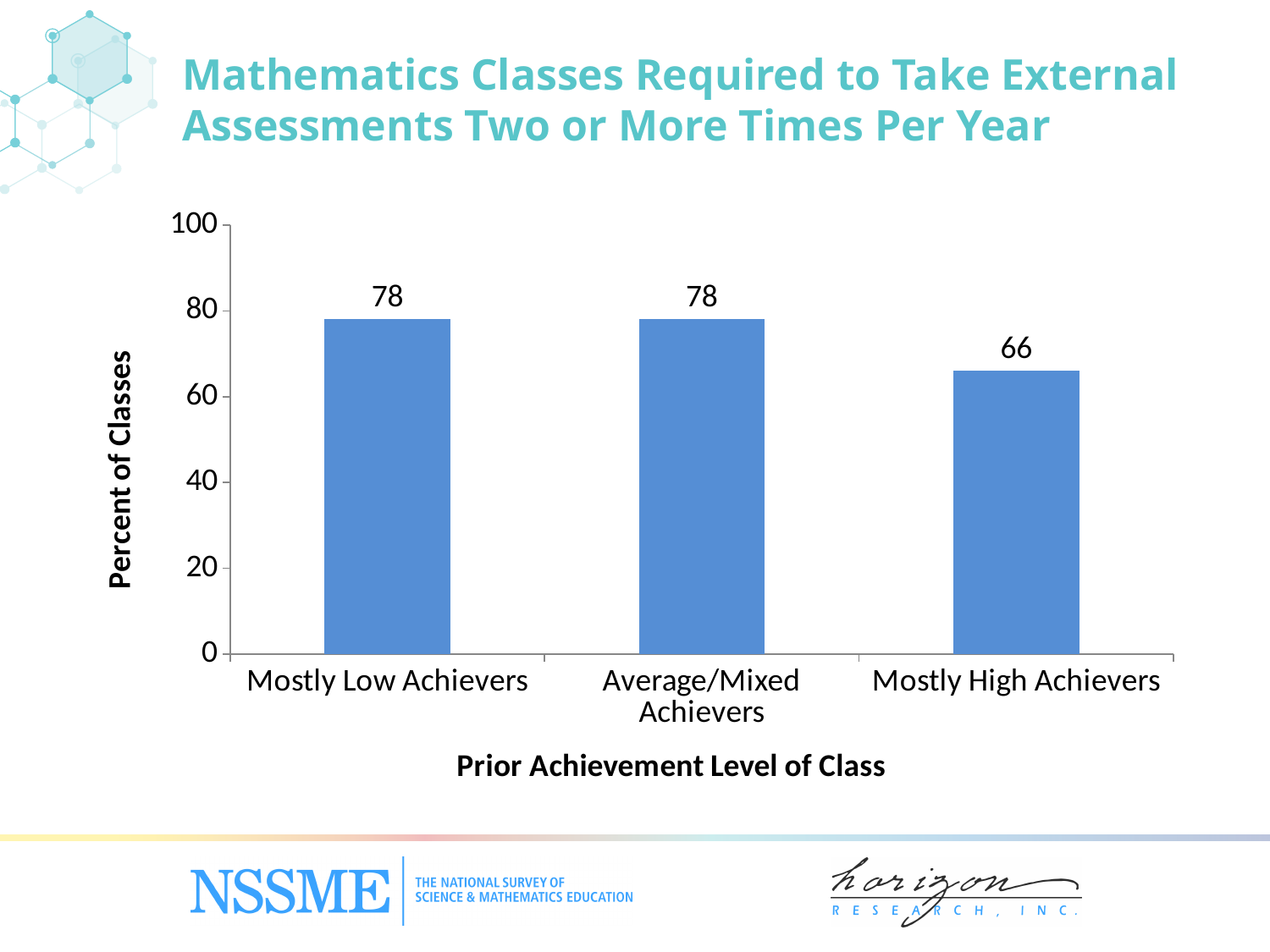
What is the value for Mostly High Achievers? 66 What is the difference between the values for Mostly Low Achievers and Mostly High Achievers? 12 Which category has the lowest value? Mostly High Achievers What is the value for Mostly Low Achievers? 78 Do the values for Mostly Low Achievers and Average/Mixed Achievers differ? No, both are 78 What kind of chart is shown on the slide? bar chart What is the label of the y axis? Percent of Classes What is the value for Average/Mixed Achievers? 78 What is the label of the x axis? Prior Achievement Level of Class Which is larger, the value for Average/Mixed Achievers or the value for Mostly High Achievers? Average/Mixed Achievers How many categories are shown on the x axis? 3 Is the value for Mostly High Achievers greater or less than 80? less